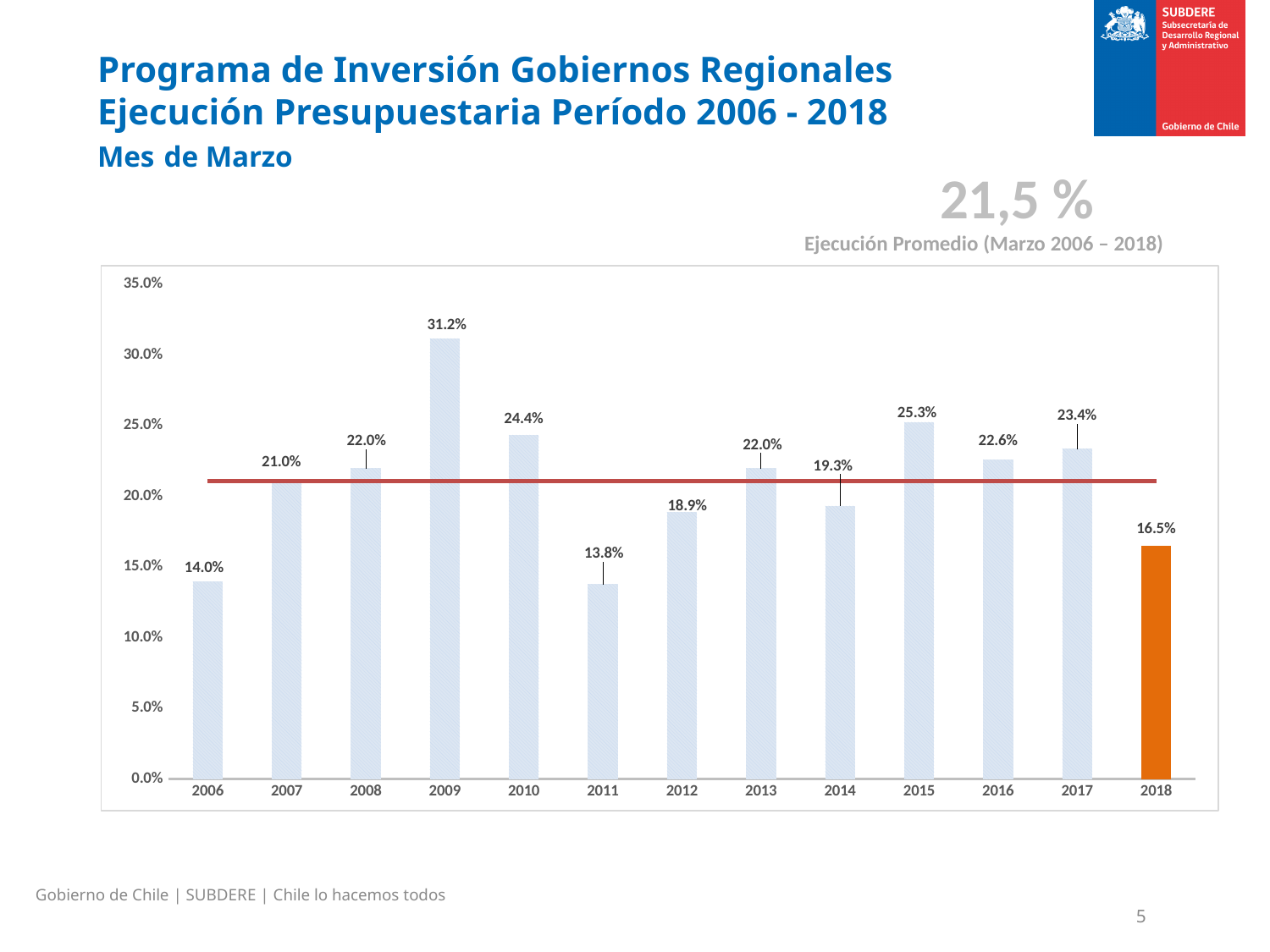
Which year has the highest value? 2009 Which year has the lowest value? 2011 What is the value for 2018? 16.5% Which is larger, the value for 2015 or the value for 2017? 2015 Is the value for 2014 greater or less than 20.0%? less What is the difference between the values for 2009 and 2011? 17.4% What average execution value is shown above the chart? 21,5 % What is the value for 2011? 13.8% What kind of chart is shown? bar chart How many years are shown on the x axis? 13 What is the value for 2009? 31.2%